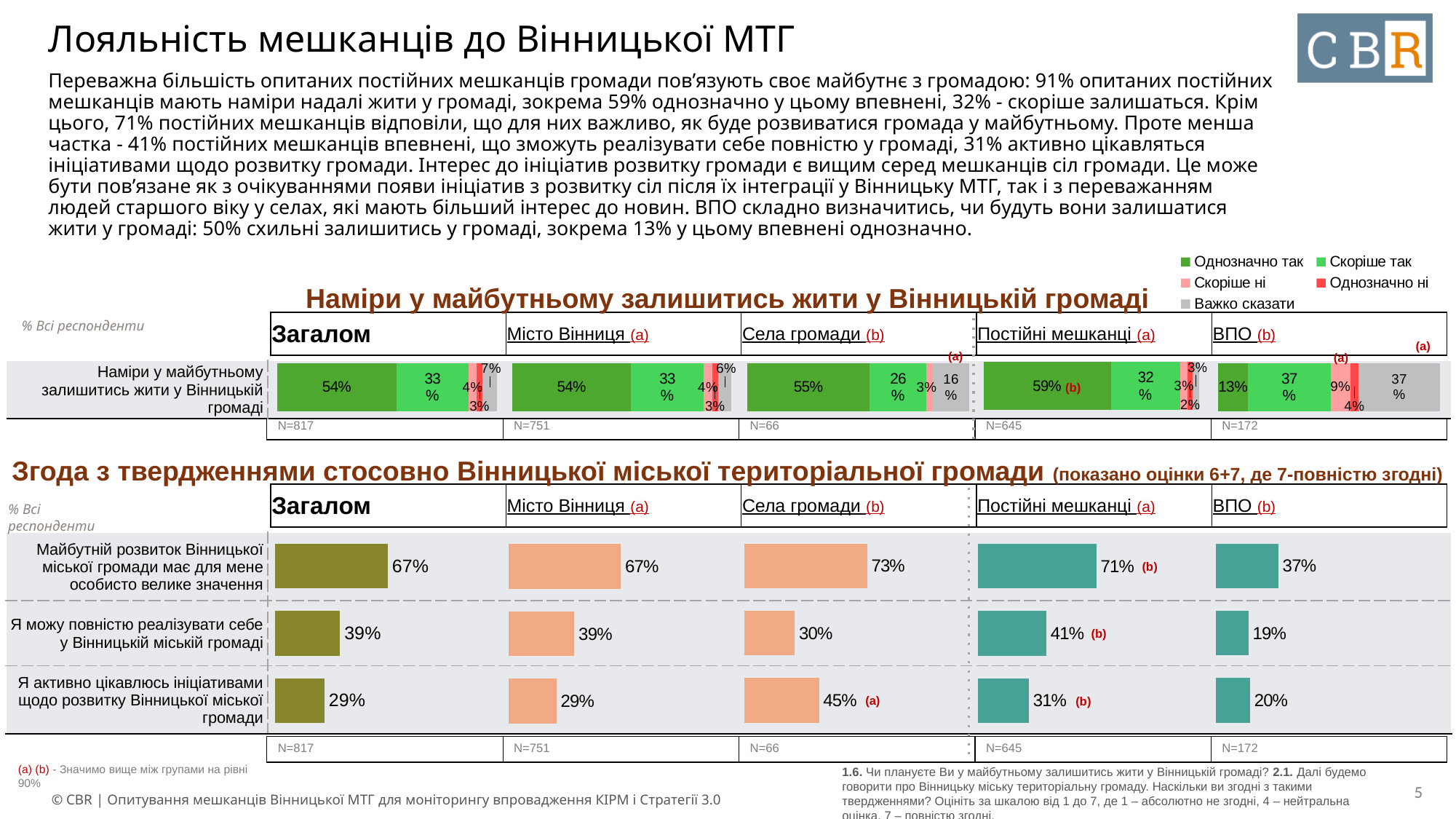
In the chart 'Згода з твердженнями стосовно Вінницької міської територіальної громади', which group has the lowest value for 'Я можу повністю реалізувати себе у Вінницькій міській громаді'? ВПО In the chart 'Наміри у майбутньому залишитись жити у Вінницькій громаді', which group has the highest 'Однозначно так' share? Постійні мешканці What kind of chart is used for 'Наміри у майбутньому залишитись жити у Вінницькій громаді'? Stacked bar chart What is the sample size (N) shown for the ВПО group on the slide? N=172 How many statements are shown in the chart 'Згода з твердженнями стосовно Вінницької міської територіальної громади'? 3 In the chart 'Згода з твердженнями стосовно Вінницької міської територіальної громади', what is the value for Села громади on 'Майбутній розвиток Вінницької міської громади має для мене особисто велике значення'? 73% In the chart 'Наміри у майбутньому залишитись жити у Вінницькій громаді', what is the 'Однозначно так' value for Загалом? 54% In the chart 'Наміри у майбутньому залишитись жити у Вінницькій громаді', what is the 'Важко сказати' value for ВПО? 37% In the chart 'Згода з твердженнями стосовно Вінницької міської територіальної громади', what is the difference between Постійні мешканці and ВПО on 'Майбутній розвиток Вінницької міської громади має для мене особисто велике значення'? 34 percentage points In the chart 'Наміри у майбутньому залишитись жити у Вінницькій громаді', what is the 'Однозначно так' value for Постійні мешканці? 59% In the chart 'Згода з твердженнями стосовно Вінницької міської територіальної громади', which is larger for 'Я активно цікавлюсь ініціативами щодо розвитку Вінницької міської громади': Місто Вінниця or Села громади? Села громади How many series does the legend of the chart 'Наміри у майбутньому залишитись жити у Вінницькій громаді' list? 5